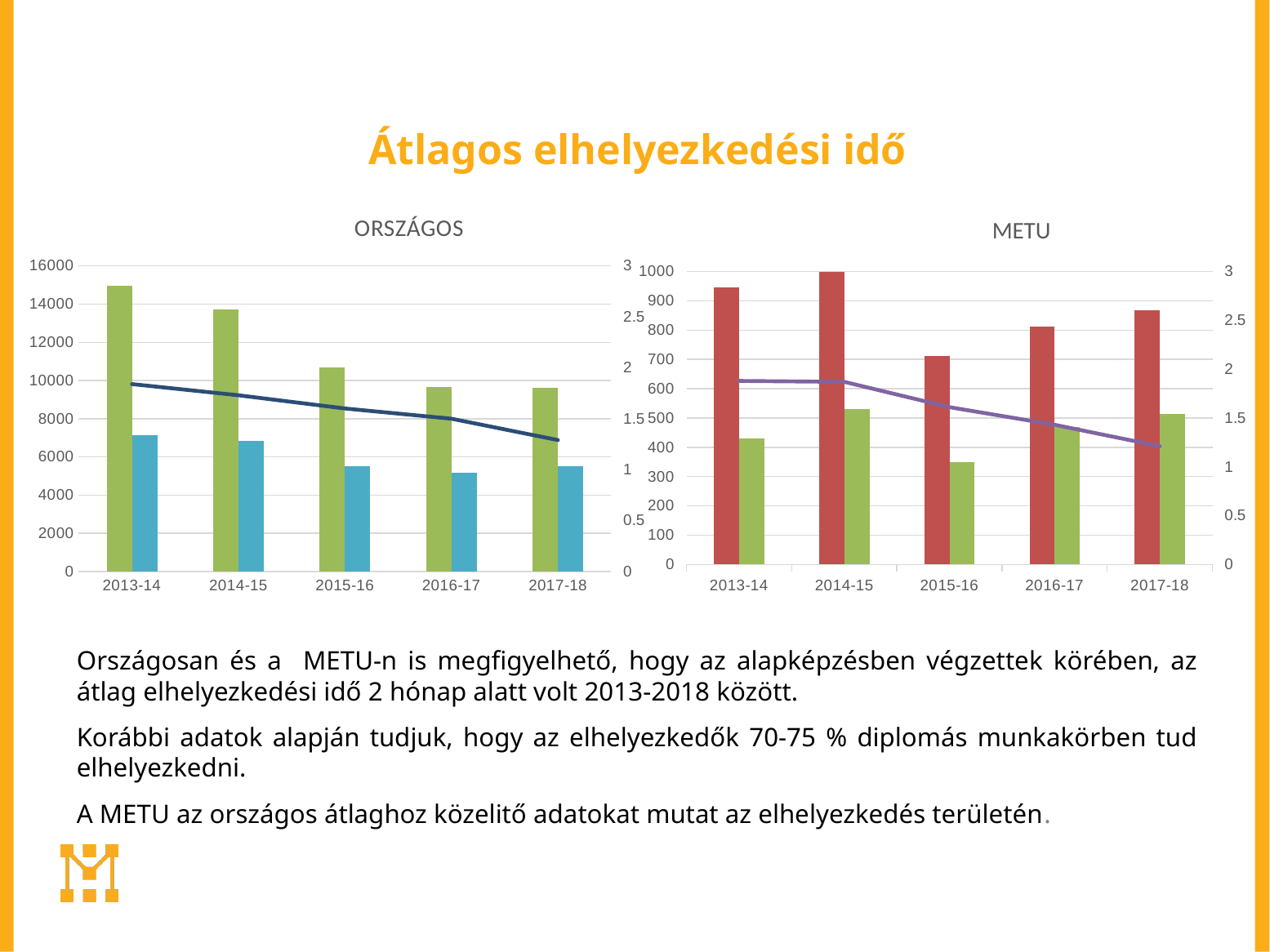
What kind of chart is the ORSZÁGOS chart? Bar chart with a line In the METU chart, which category has the shortest green bar? 2015-16 In the METU chart, does the line rise or fall from 2013-14 to 2017-18? Falls In the METU chart, is the red bar for 2015-16 greater or less than 800? less In the ORSZÁGOS chart, how many categories are shown on the x axis? 5 How many charts are shown on the slide? 2 In the METU chart, how many categories are shown on the x axis? 5 In the ORSZÁGOS chart, does the line rise or fall from 2013-14 to 2017-18? Falls In the METU chart, which category has the tallest red bar? 2014-15 In the ORSZÁGOS chart, is the green bar for 2013-14 greater or less than 14000? greater In the ORSZÁGOS chart, which category has the tallest green bar? 2013-14 In the ORSZÁGOS chart, which is taller for 2015-16, the green bar or the blue bar? The green bar